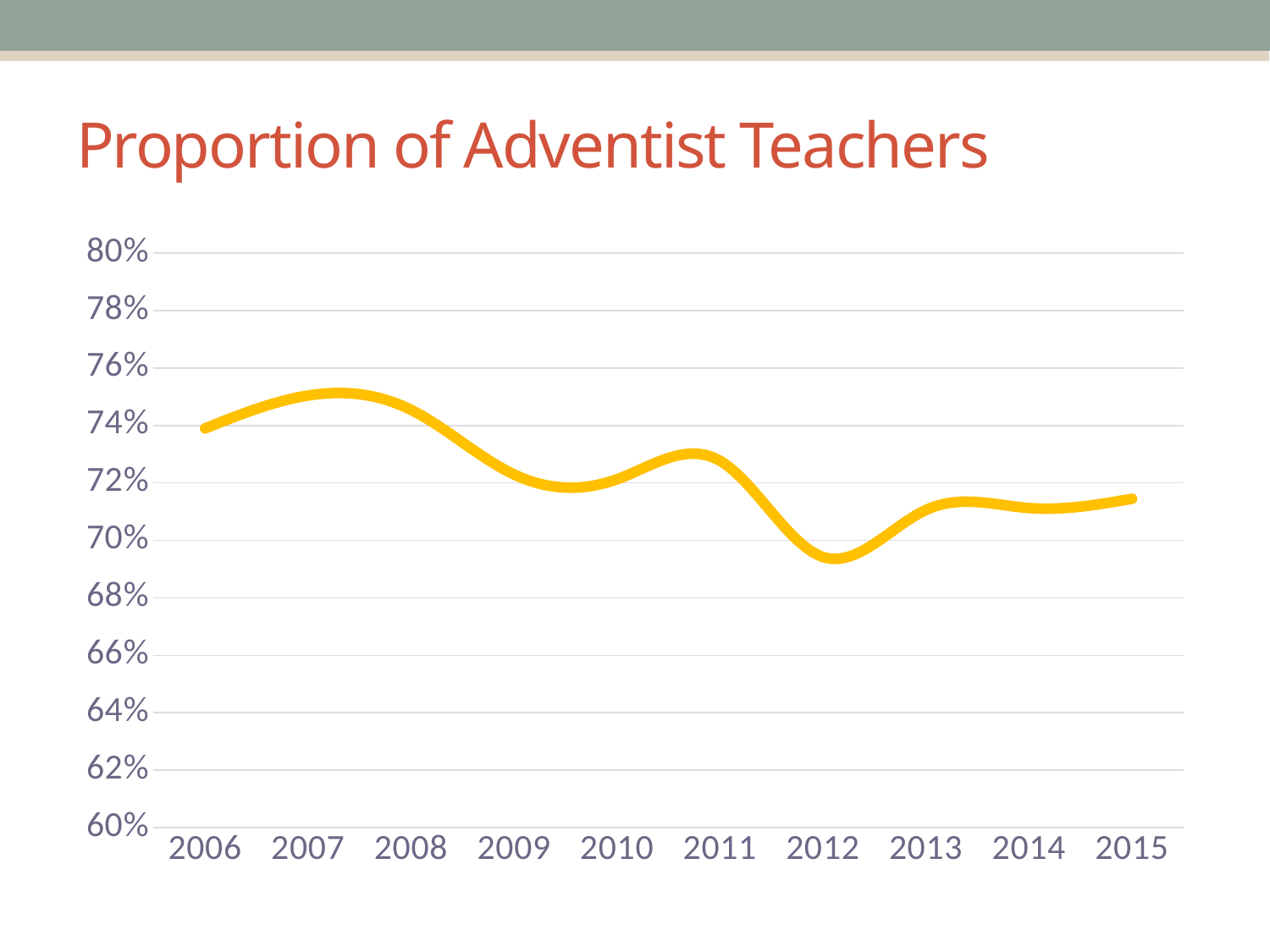
Is the value for 2015 greater or less than 74%? less Is the value for 2012 greater or less than 72%? less Which year has the lowest proportion of Adventist teachers? 2012 Which year has a higher proportion, 2007 or 2012? 2007 What is the title of the chart? Proportion of Adventist Teachers How many years are plotted along the x axis? 10 Which year has the highest proportion of Adventist teachers? 2007 Is the value for 2006 greater or less than 72%? greater What kind of chart is shown on the slide? line chart Which year has a higher proportion, 2006 or 2013? 2006 Overall, does the proportion of Adventist teachers rise or fall from 2006 to 2015? fall